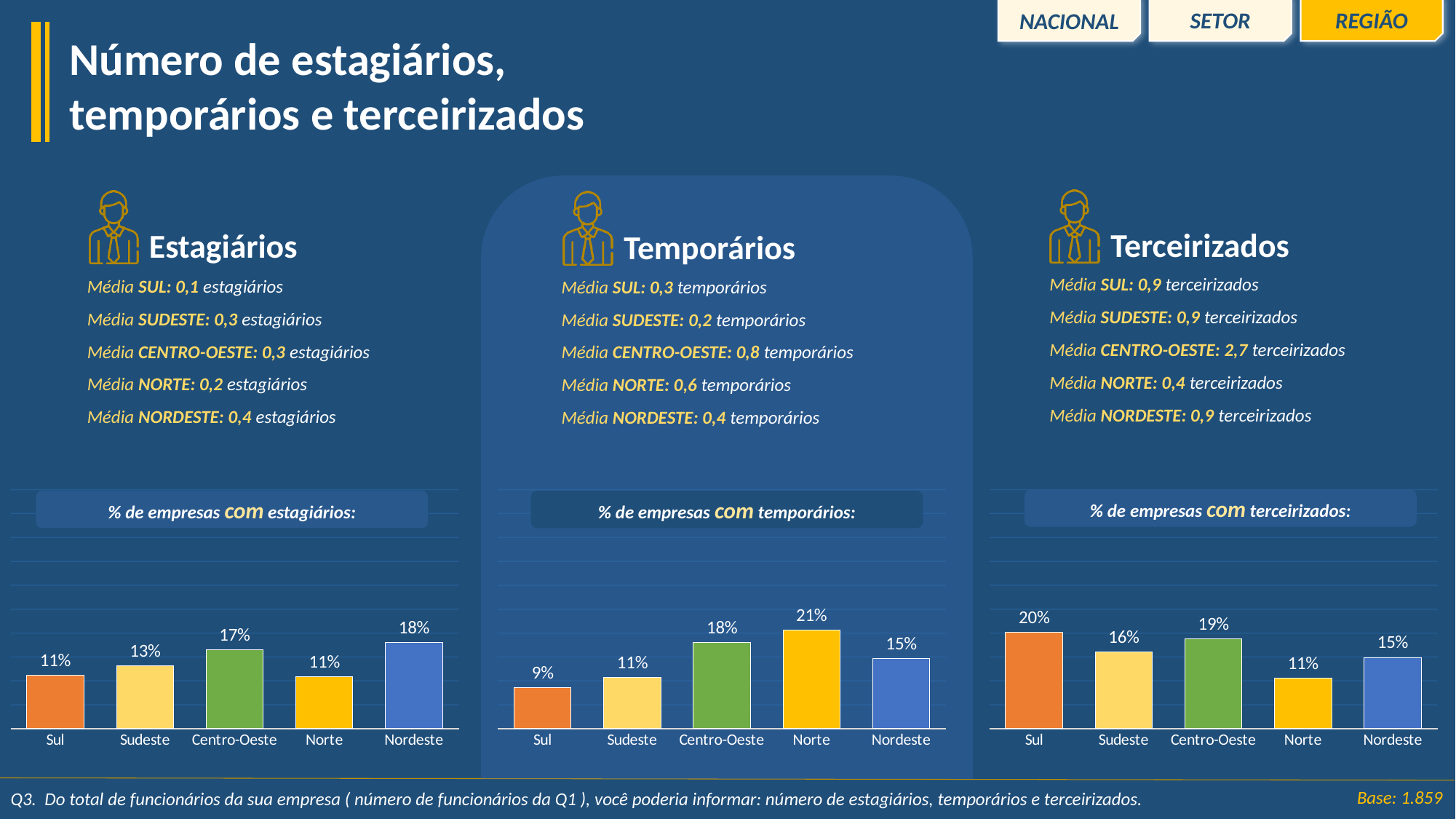
In the '% de empresas com estagiários' chart, what is the value for Nordeste? 18% In the '% de empresas com temporários' chart, what is the value for Norte? 21% What type of chart is used for '% de empresas com estagiários'? Bar chart In the '% de empresas com terceirizados' chart, what is the value for Sul? 20% In the '% de empresas com terceirizados' chart, which is larger, Sul or Centro-Oeste? Sul In the '% de empresas com estagiários' chart, which region has the lowest value? Sul and Norte (both 11%) In the '% de empresas com temporários' chart, what is the difference between Centro-Oeste and Sudeste? 7 percentage points In the '% de empresas com temporários' chart, which region has the lowest value? Sul How many regions are shown in the '% de empresas com terceirizados' chart? 5 In the '% de empresas com estagiários' chart, what is the difference between Nordeste and Sul? 7 percentage points In the '% de empresas com terceirizados' chart, which region has the lowest value? Norte In the '% de empresas com temporários' chart, which region has the highest value? Norte